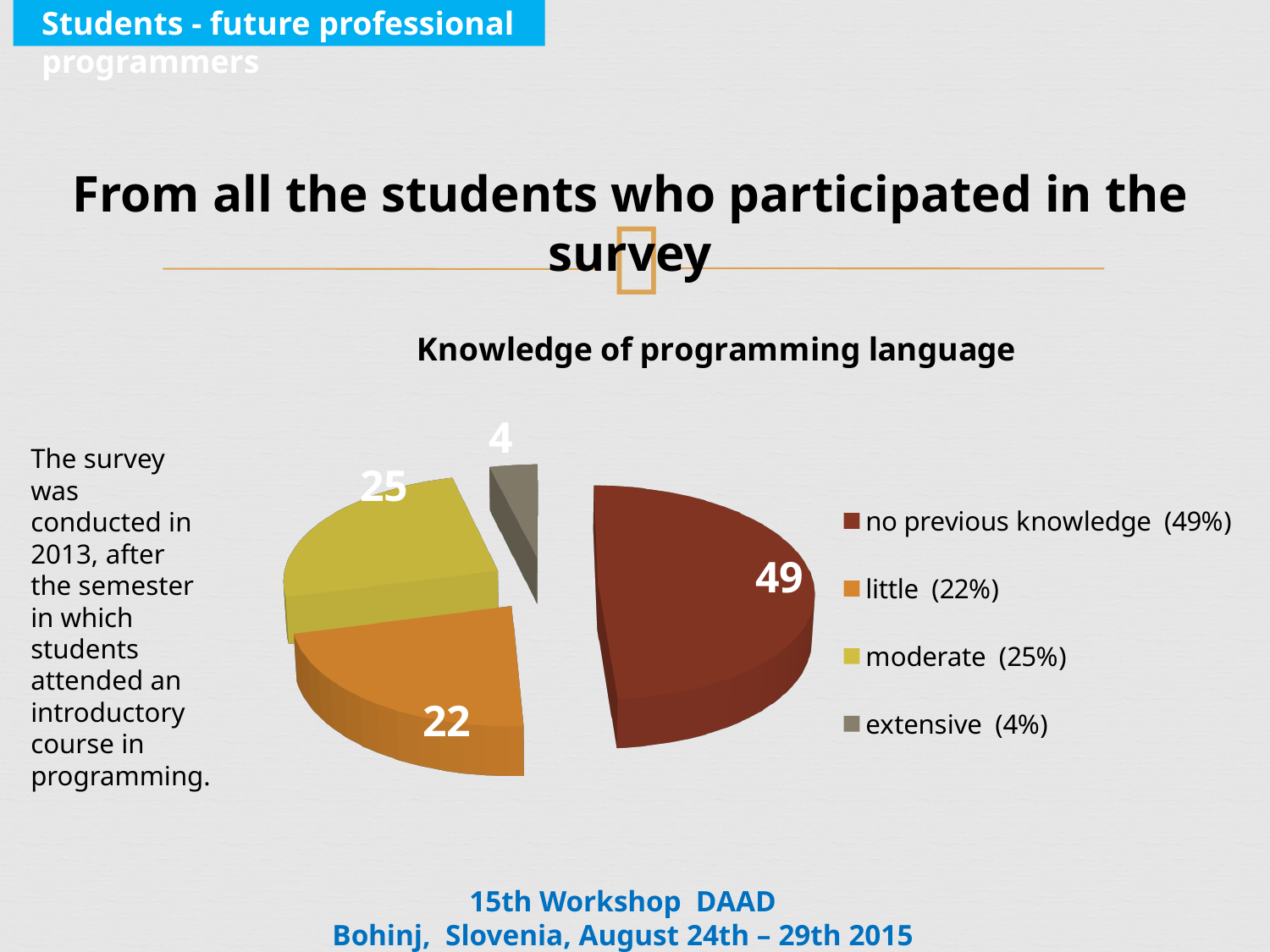
What is the value for the 'moderate' slice? 25 What is the value for the 'little' slice? 22 What is the value for the 'no previous knowledge' slice? 49 What type of chart is shown on the slide? pie chart What share of the pie does the 'extensive' slice represent, according to the legend? 4% Which category has the largest slice? no previous knowledge Which is larger, the 'moderate' slice or the 'little' slice? moderate What is the title of the chart? Knowledge of programming language Which category has the smallest slice? extensive What is the difference between the 'no previous knowledge' value and the 'moderate' value? 24 What is the value for the 'extensive' slice? 4 How many categories does the pie chart have? 4